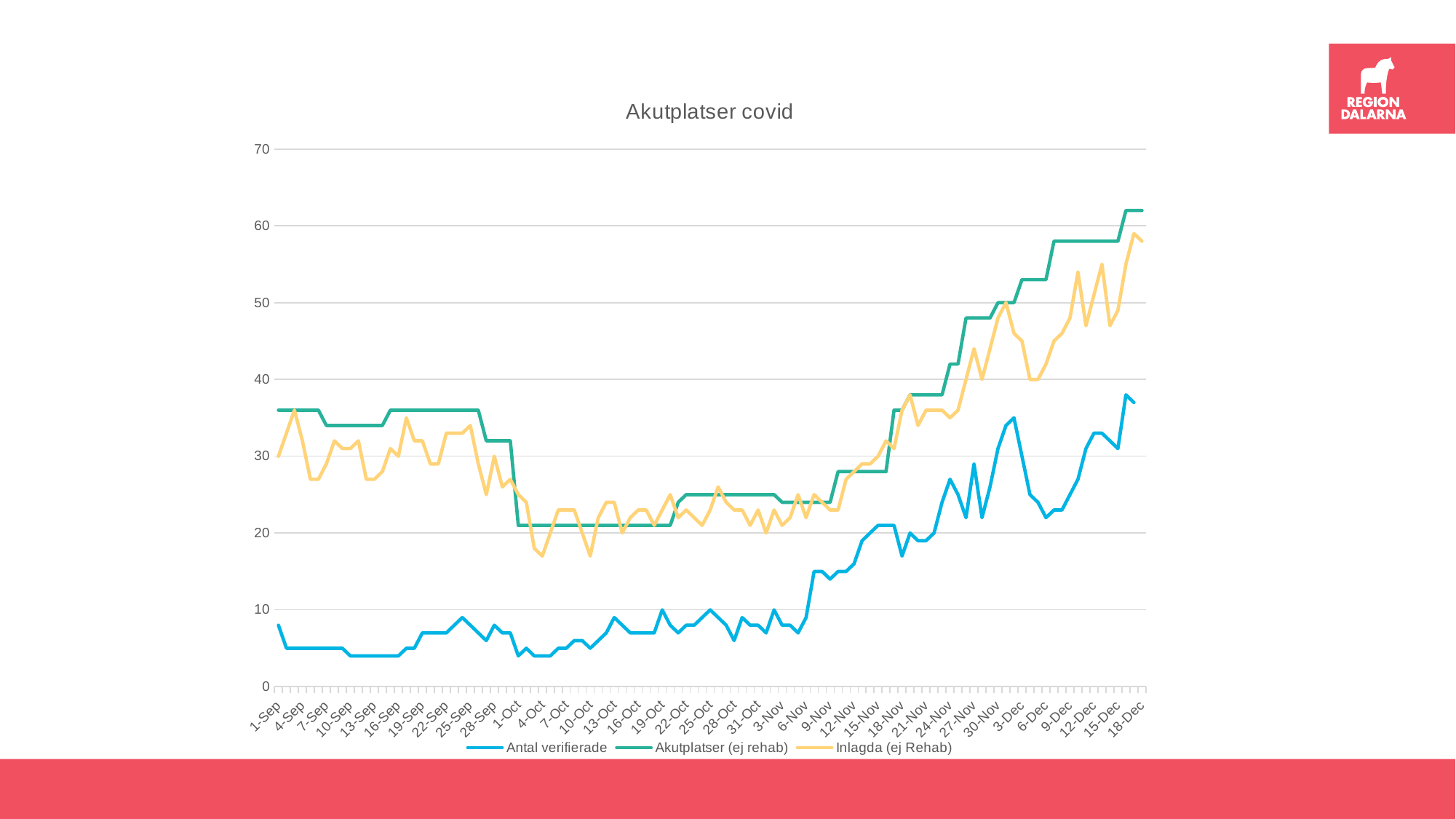
What is the title of the chart? Akutplatser covid Is the value for Akutplatser (ej rehab) on 18-Dec greater or less than 60? greater How many series does the legend list? 3 Is the value for Akutplatser (ej rehab) on 1-Sep greater or less than 30? greater Which series is drawn in blue according to the legend? Antal verifierade What kind of chart is shown on the slide? line chart Which series reaches the highest value on the chart? Akutplatser (ej rehab) Is the value for Antal verifierade on 1-Sep greater or less than 10? less Does the Antal verifierade series rise or fall overall from 1-Sep to 18-Dec? rise